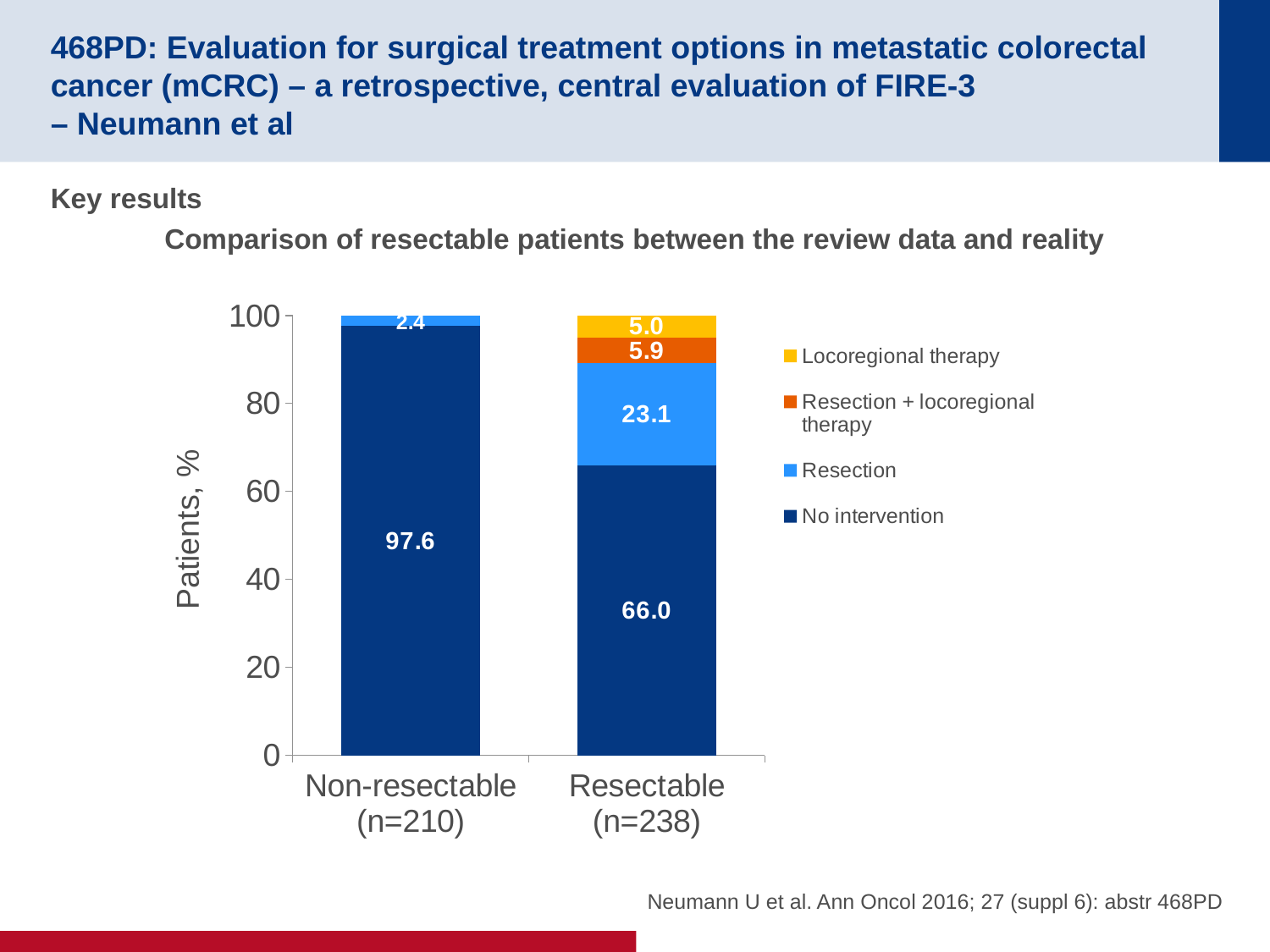
What is the value for No intervention in the Non-resectable (n=210) group? 97.6 Which group has the higher value for No intervention? Non-resectable (n=210) What is the difference between the Resection values for the Resectable and Non-resectable groups? 20.7 What is the value for Resection + locoregional therapy in the Resectable (n=238) group? 5.9 What is the value for Resection in the Resectable (n=238) group? 23.1 How many groups are shown on the x axis? 2 What kind of chart is shown on the slide? Stacked bar chart What is the difference between the No intervention values for the Non-resectable and Resectable groups? 31.6 What is the label of the y axis? Patients, % How many series does the legend list? 4 What is the value for Locoregional therapy in the Resectable (n=238) group? 5.0 What is the value for Resection in the Non-resectable (n=210) group? 2.4